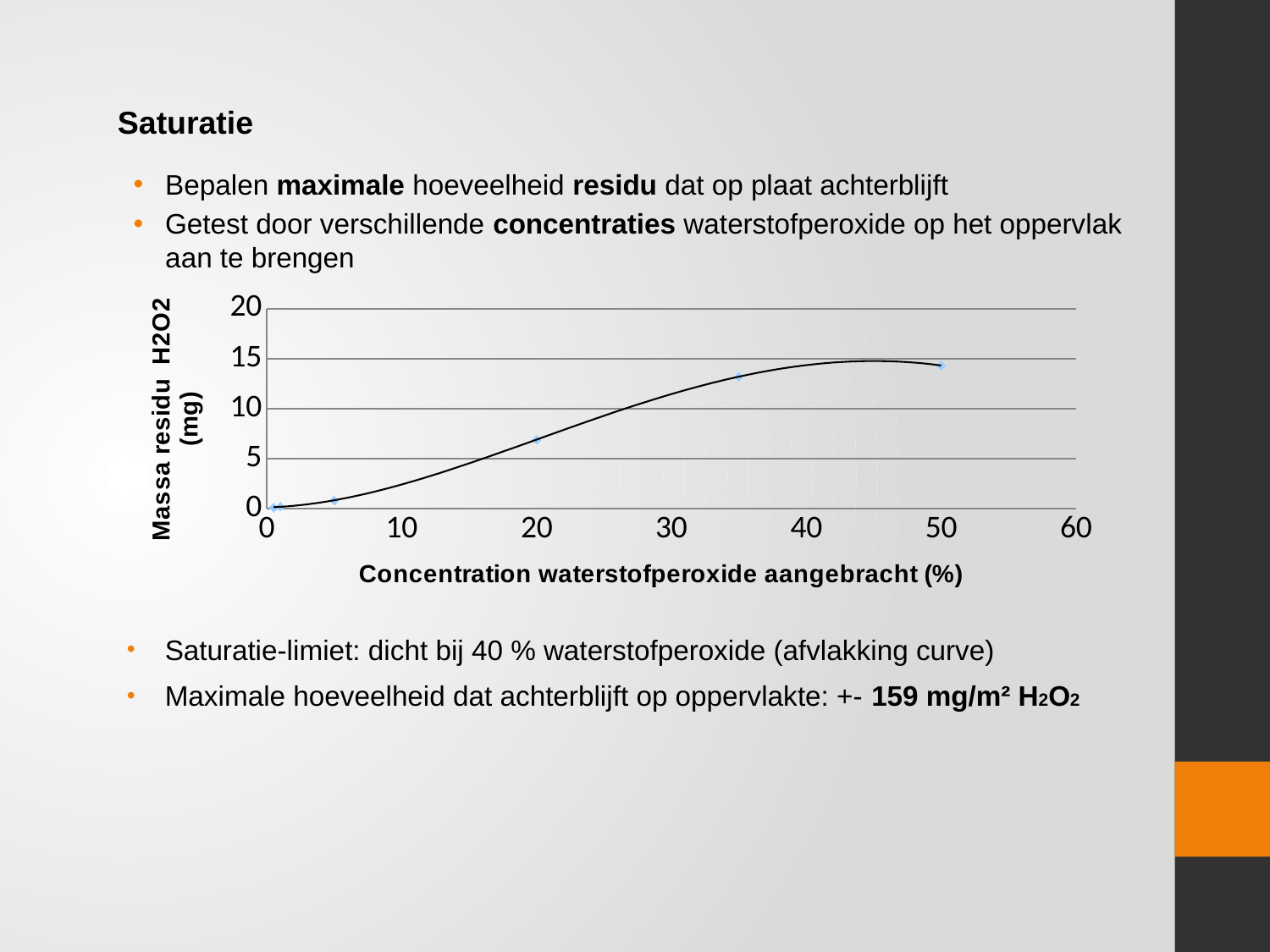
What is the title of the y axis of the chart? Massa residu H2O2 (mg) Which has the larger residue mass: the point at 20% concentration or the point at 35% concentration? 35% What is the title of the x axis of the chart? Concentration waterstofperoxide aangebracht (%) Is the value for a concentration of 50% greater or less than 15? less Do the plotted values generally rise or fall as the concentration increases along the x axis? rise What is the highest value shown on the y axis of the chart? 20 What kind of chart is shown on the slide? Scatter chart with a trend line At which concentration is the plotted residue mass highest? 50 Is the value for a concentration of 5% greater or less than 5? less Is the value for a concentration of 35% greater or less than 10? greater